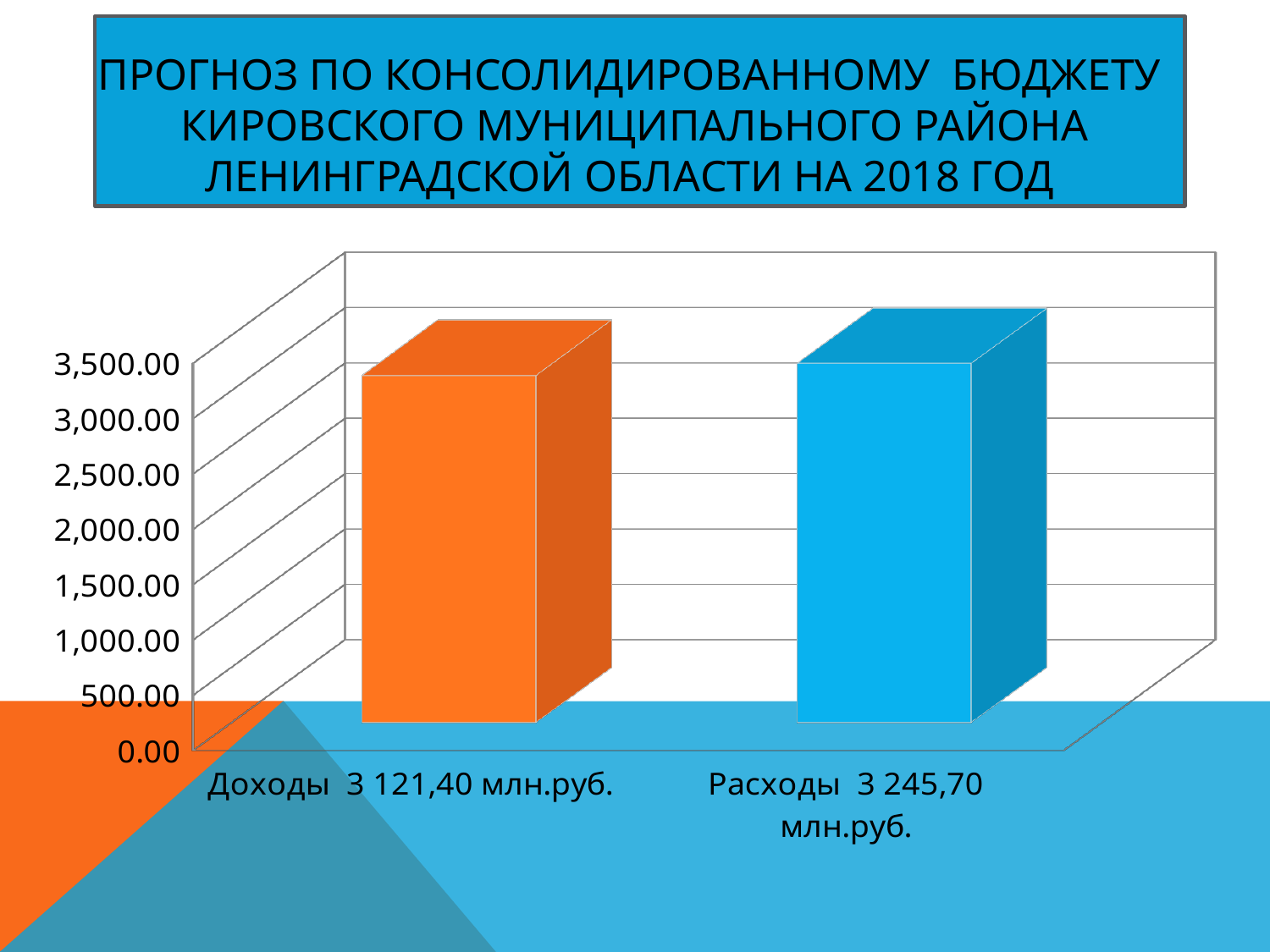
Which is larger, Доходы or Расходы? Расходы Is the value for Доходы greater or less than 3,000.00? greater What is the value for Доходы? 3 121,40 млн.руб. How many categories are shown in the chart? 2 What is the value for Расходы? 3 245,70 млн.руб. What year does the slide title say the budget forecast is for? 2018 What kind of chart is shown on the slide? bar chart What colour is the bar for Доходы? orange Which category has the lowest value? Доходы Which category has the highest value? Расходы Is the value for Расходы greater or less than 3,500.00? less What is the difference between Расходы and Доходы? 124,30 млн.руб.